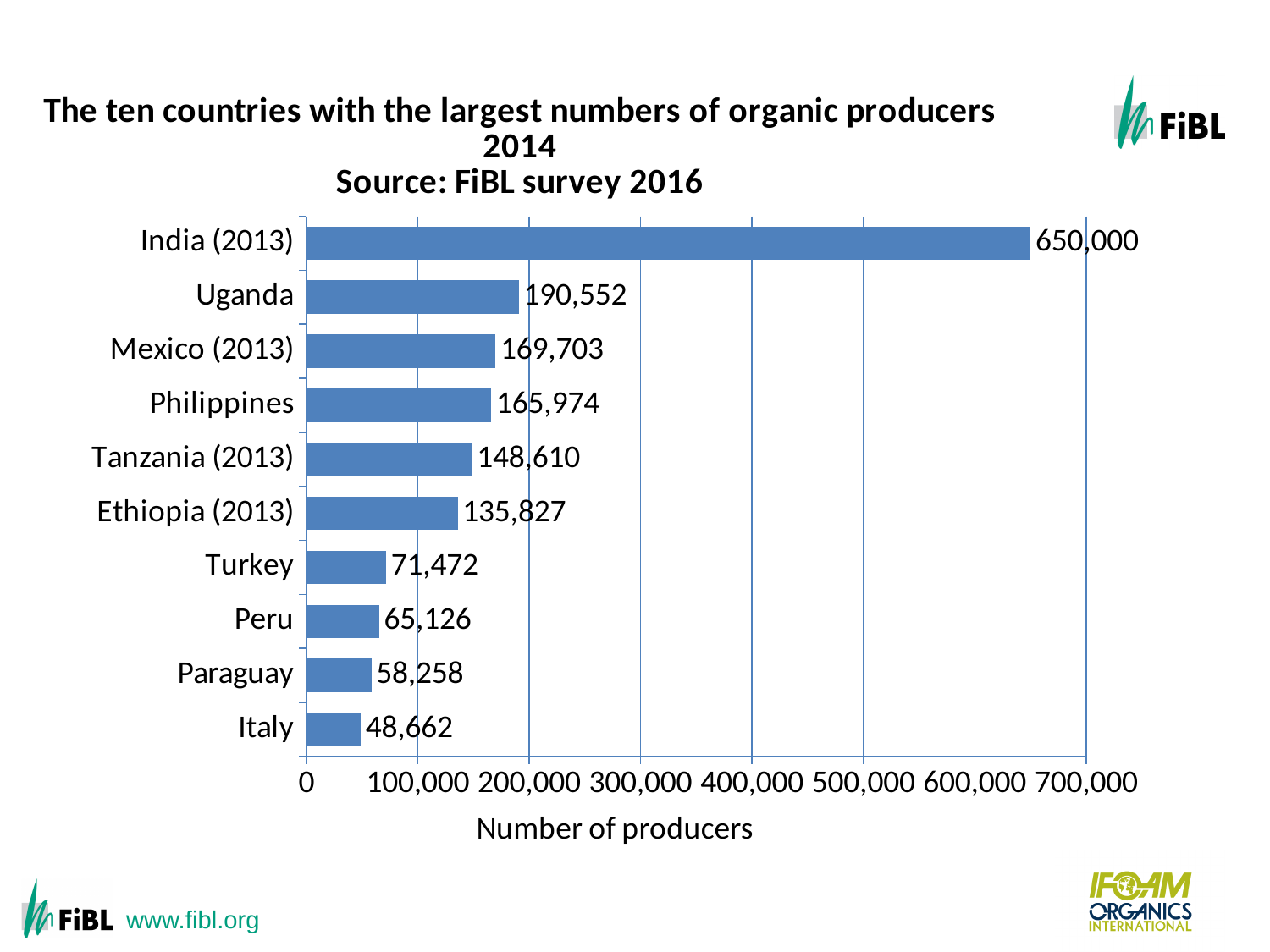
What is the number of organic producers for Turkey? 71,472 What kind of chart is shown on the slide? Bar chart What is the label of the horizontal axis? Number of producers What is the number of organic producers for Uganda? 190,552 What is the difference in the number of producers between India (2013) and Uganda? 459,448 Which country has the largest number of organic producers? India (2013) What is the difference in the number of producers between Peru and Paraguay? 6,868 How many countries are shown in the chart? 10 Is the value for Mexico (2013) greater or less than 100,000? greater What is the number of organic producers for Italy? 48,662 Which country has the smallest number of organic producers? Italy Which has more organic producers, Tanzania (2013) or Ethiopia (2013)? Tanzania (2013)